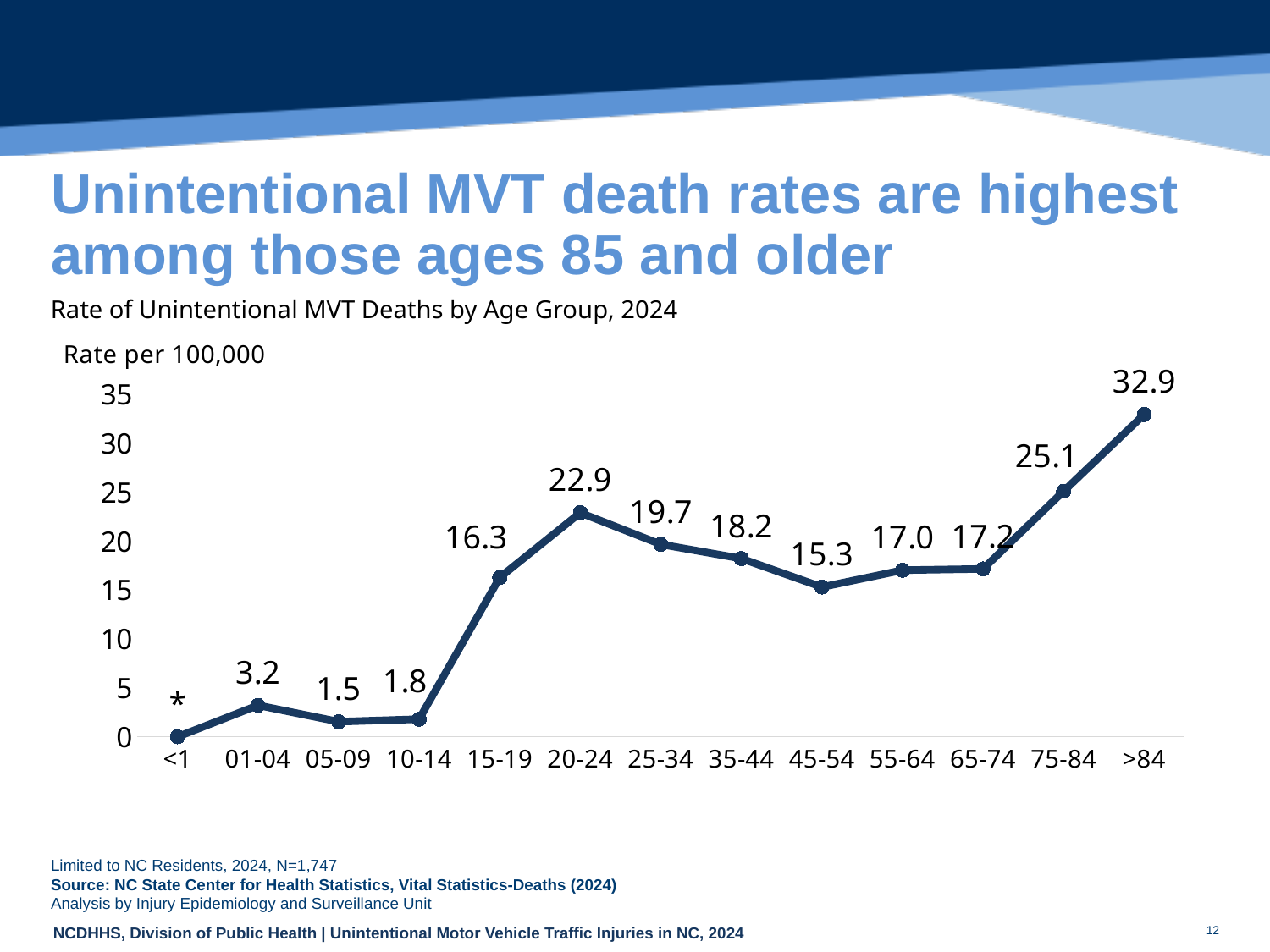
Do the rates rise or fall from the 45-54 age group to the >84 age group? Rise Which age group has the highest rate of unintentional MVT deaths? >84 How many age groups are plotted on the chart? 13 What is the rate shown for the 01-04 age group? 3.2 Among the age groups with a printed value, which has the lowest rate? 05-09 What is the difference between the rates for the 20-24 and 15-19 age groups? 6.6 What is the rate per 100,000 for the 75-84 age group? 25.1 What is the rate of unintentional MVT deaths for the 20-24 age group? 22.9 What is the rate shown for the 45-54 age group? 15.3 What kind of chart is shown on the slide? Line chart What is the difference between the rates for the >84 and 75-84 age groups? 7.8 Which age group has a higher rate, 25-34 or 35-44? 25-34